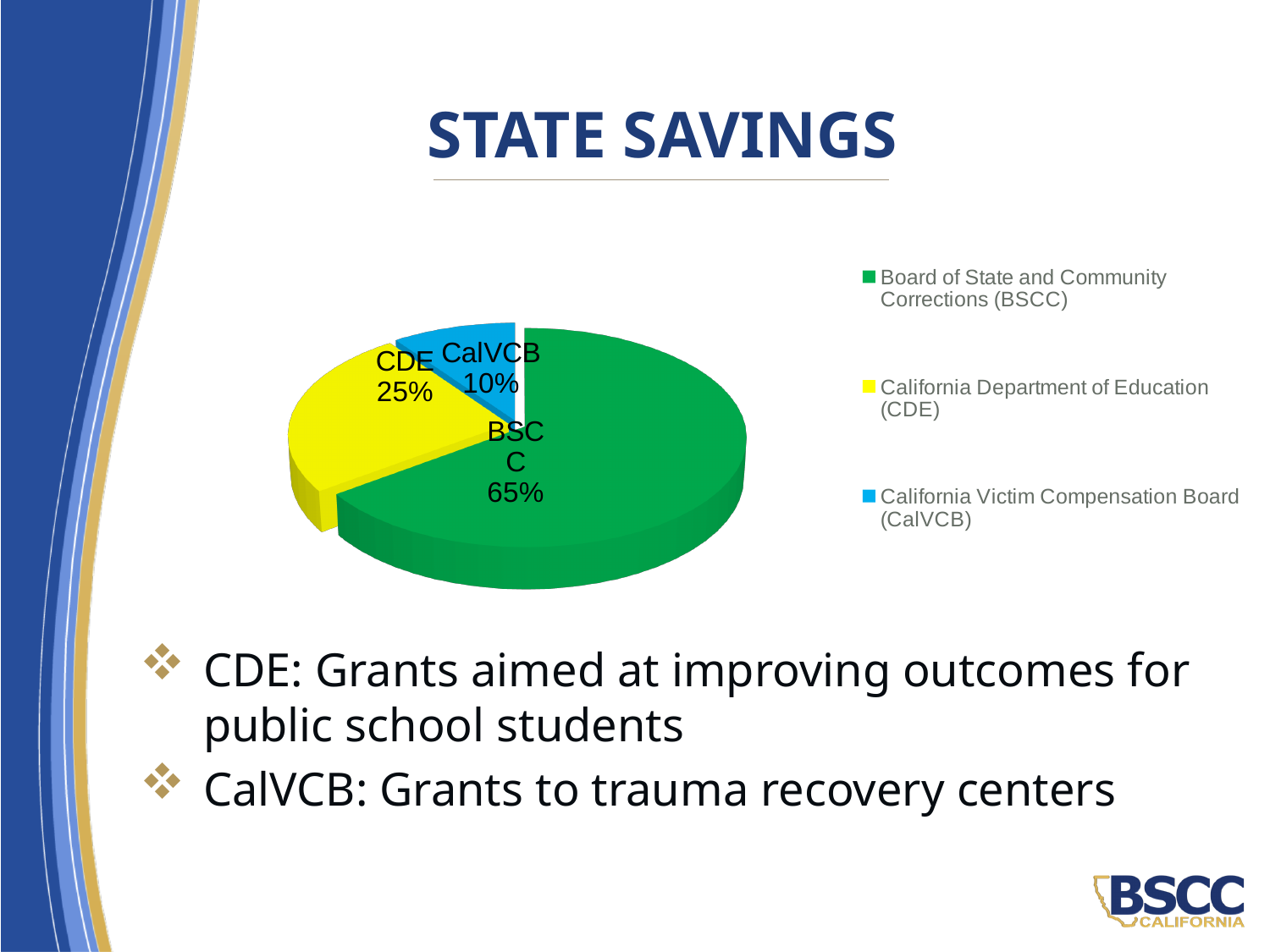
Which category has the largest slice of the pie? BSCC Which category has the smallest slice of the pie? CalVCB What colour is the slice for the California Department of Education (CDE)? Yellow How many slices does the pie chart have? 3 What share of state savings goes to CDE? 25% What is the difference in percentage points between the BSCC and CDE slices? 40 What share of state savings goes to CalVCB? 10% What is the full name of the organisation abbreviated as CalVCB in the legend? California Victim Compensation Board What is the difference in percentage points between the CDE and CalVCB slices? 15 What share of state savings goes to BSCC? 65% Which is larger, the CDE slice or the CalVCB slice? CDE What kind of chart is shown on the slide? Pie chart